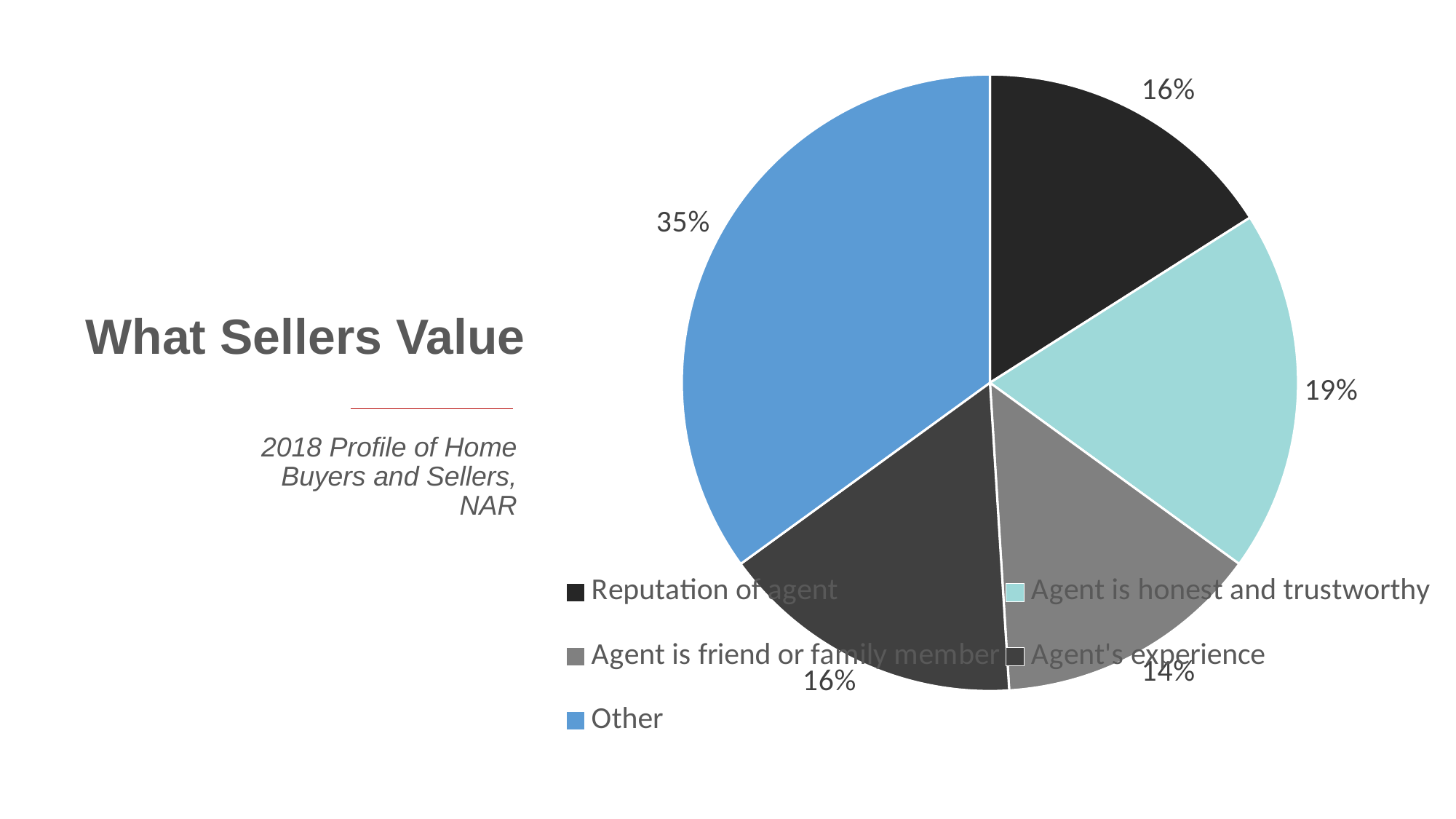
How many categories does the legend list? 5 Which is larger, the slice for "Agent is honest and trustworthy" or the slice for "Agent's experience"? Agent is honest and trustworthy Which category has the largest slice of the pie? Other What is the title of the slide containing the chart? What Sellers Value What percentage is shown for "Agent is friend or family member"? 14% What kind of chart is shown on the slide? pie chart What colour is the slice for "Other"? blue What percentage is shown for "Agent is honest and trustworthy"? 19% What is the difference in percentage points between "Other" and "Agent is honest and trustworthy"? 16 Which category has the smallest slice of the pie? Agent is friend or family member What percentage is shown for "Reputation of agent"? 16% What share of the pie is labelled for "Other"? 35%